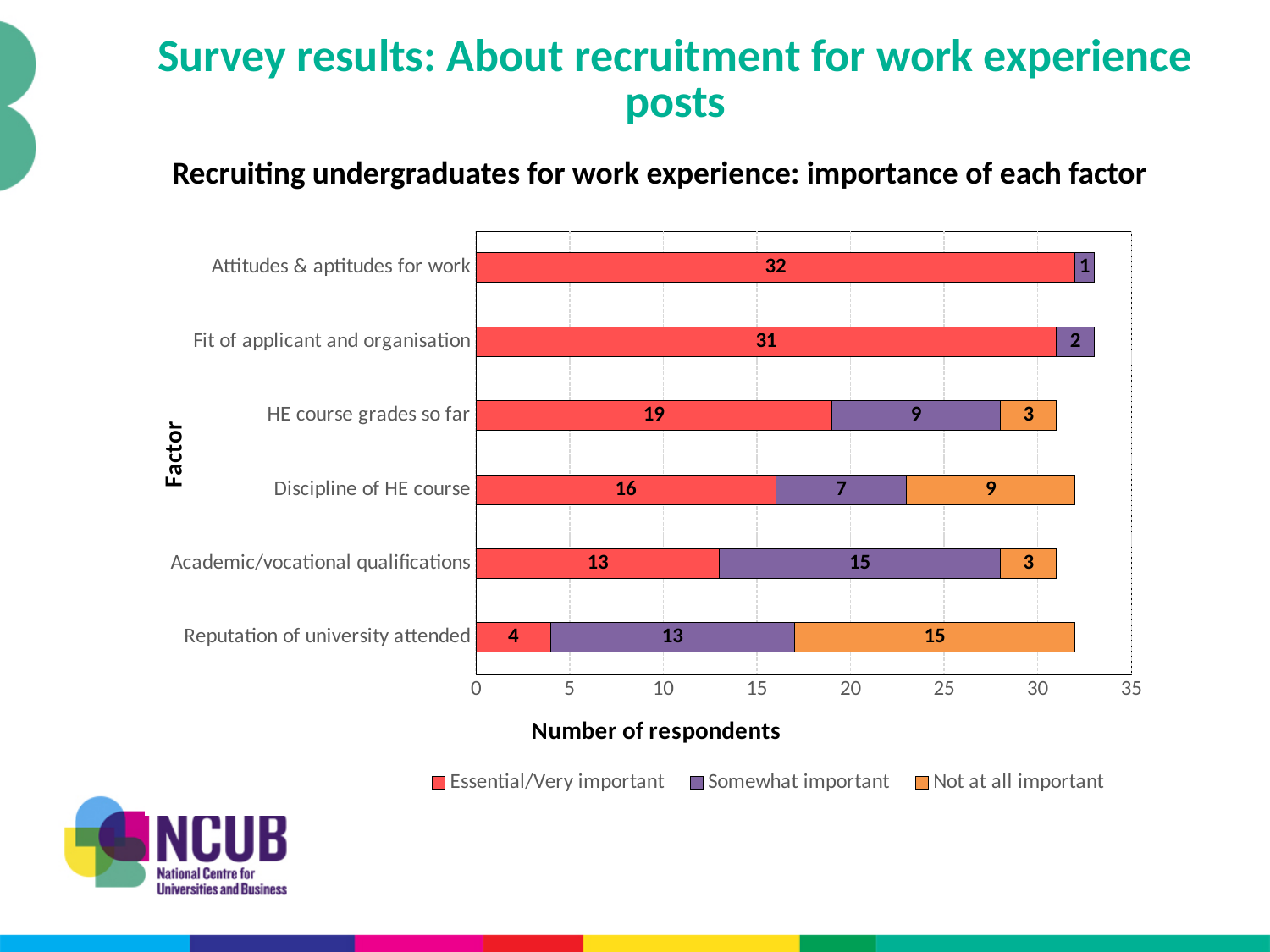
How many factors are listed on the y axis of the chart? 6 Which factor has the highest number of Essential/Very important responses? Attitudes & aptitudes for work How many series does the legend list? 3 What kind of chart is shown on the slide? Stacked bar chart How many respondents rated 'Reputation of university attended' as Not at all important? 15 What is the label of the x axis? Number of respondents How many respondents rated 'Attitudes & aptitudes for work' as Essential/Very important? 32 How many respondents rated 'Academic/vocational qualifications' as Somewhat important? 15 Which factor has the lowest number of Essential/Very important responses? Reputation of university attended What is the difference between the Essential/Very important counts for 'HE course grades so far' and 'Discipline of HE course'? 3 Which has more Not at all important responses: 'Discipline of HE course' or 'HE course grades so far'? Discipline of HE course What is the total number of respondents for 'Reputation of university attended' across all three categories? 32